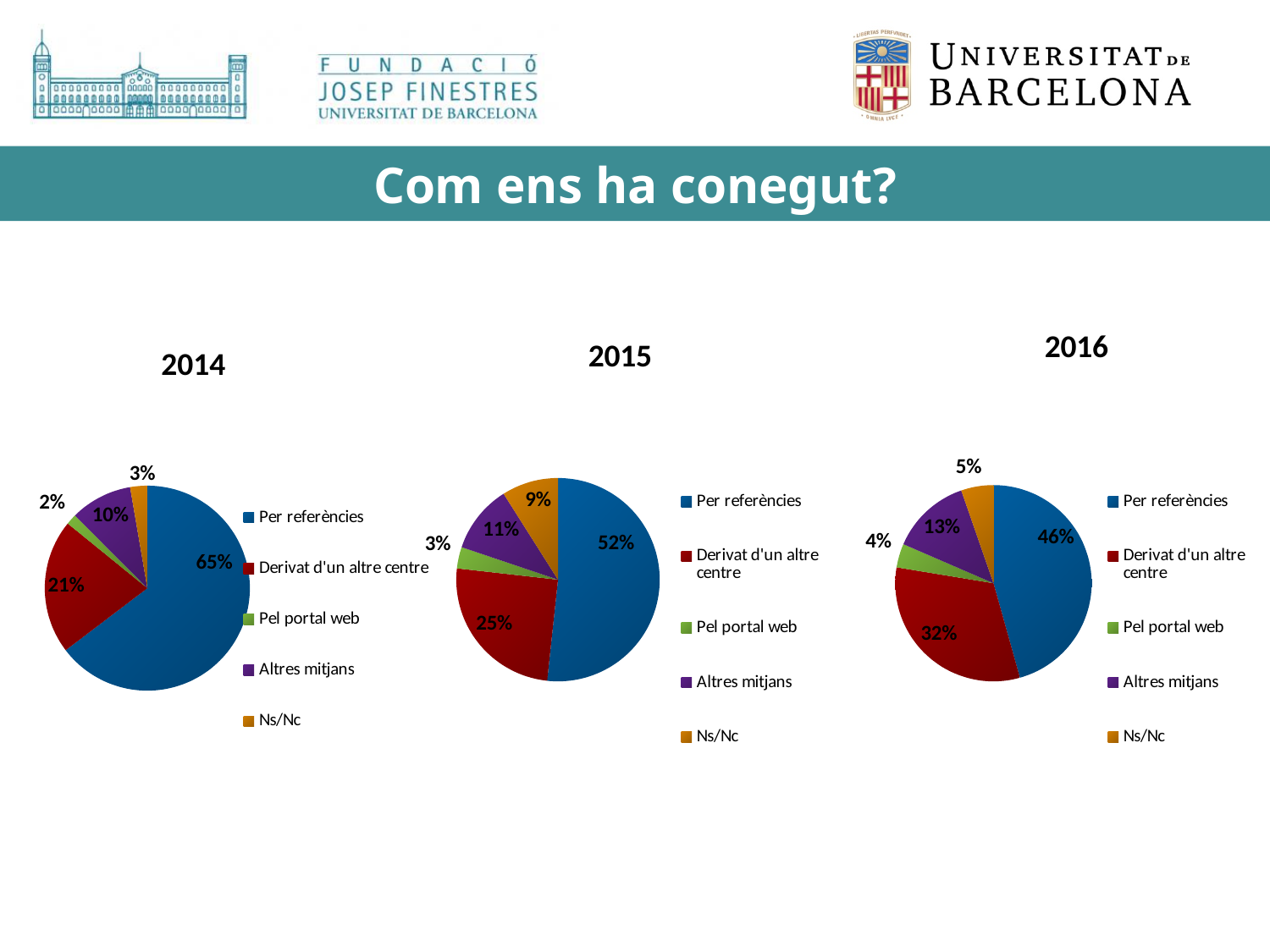
In the 2016 pie chart, which category has the largest slice? Per referències In the 2015 pie chart, what is the difference between the Per referències share and the Derivat d'un altre centre share? 27% In the 2014 pie chart, what share is labelled for Per referències? 65% What is the title shown above the three charts on the slide? Com ens ha conegut? In the 2016 pie chart, what share is labelled for Altres mitjans? 13% How many entries does the legend of the 2014 chart list? 5 What type of chart is used for the 2016 data? Pie chart How many slices does the 2015 pie chart have? 5 In the 2014 pie chart, which category has the smallest slice? Pel portal web In the 2016 pie chart, what share is labelled for Ns/Nc? 5% In the 2016 pie chart, which is larger: Altres mitjans or Ns/Nc? Altres mitjans In the 2015 pie chart, what share is labelled for Derivat d'un altre centre? 25%